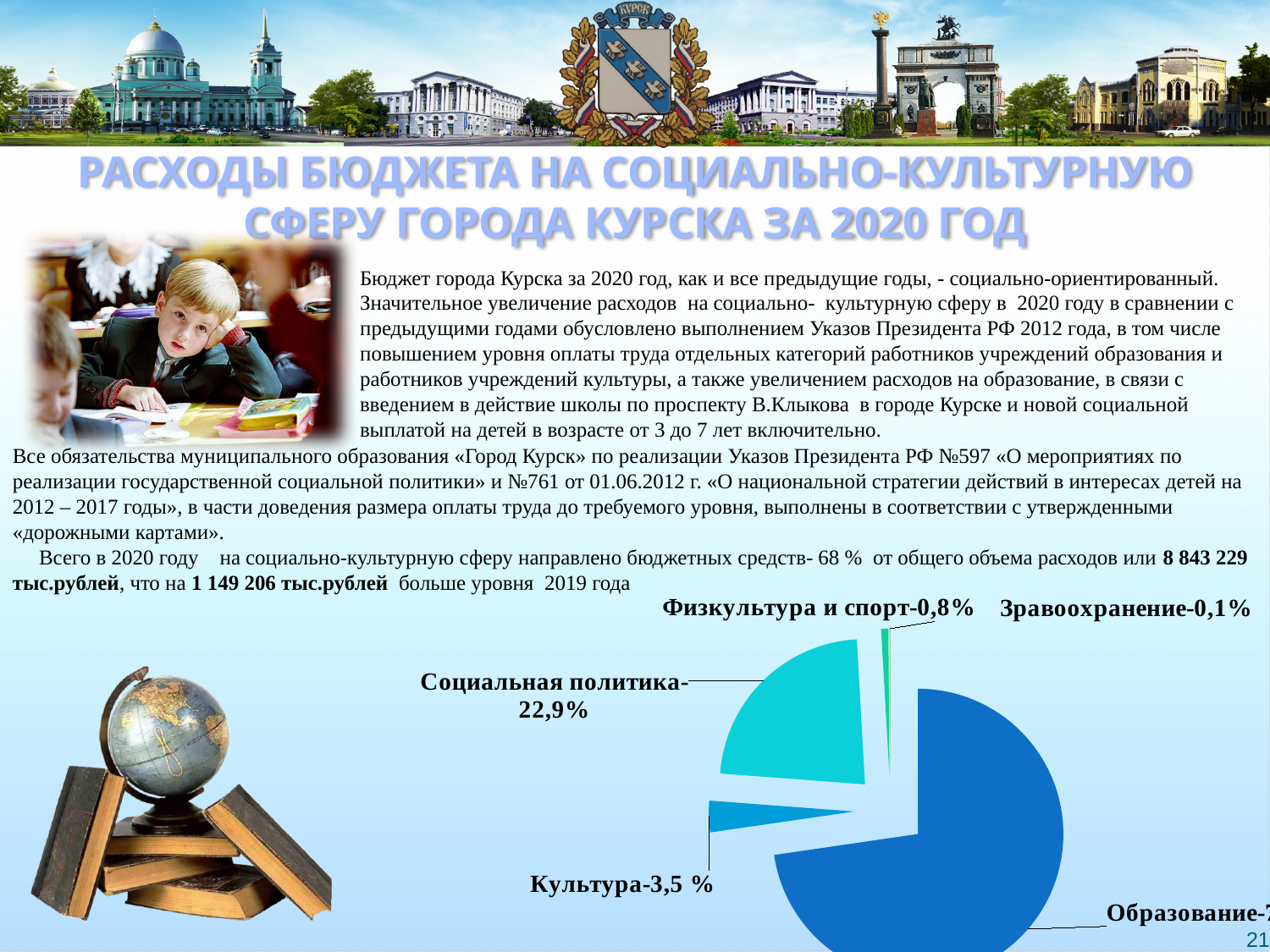
Which is larger in the pie chart: Социальная политика or Культура? Социальная политика How many categories are shown in the pie chart? 5 What kind of chart is shown on the slide? pie chart By how many percentage points does Физкультура и спорт exceed Здравоохранение in the pie chart? 0,7 By how many percentage points does Социальная политика exceed Культура in the pie chart? 19,4 What share of the pie chart does Физкультура и спорт have? 0,8% Which category has the largest slice of the pie chart? Образование Which is larger in the pie chart: Физкультура и спорт or Здравоохранение? Физкультура и спорт What share of the pie chart does Здравоохранение have? 0,1% Which category has the smallest slice of the pie chart? Здравоохранение What share of the pie chart does Культура have? 3,5 % What share of the pie chart does Социальная политика have? 22,9%